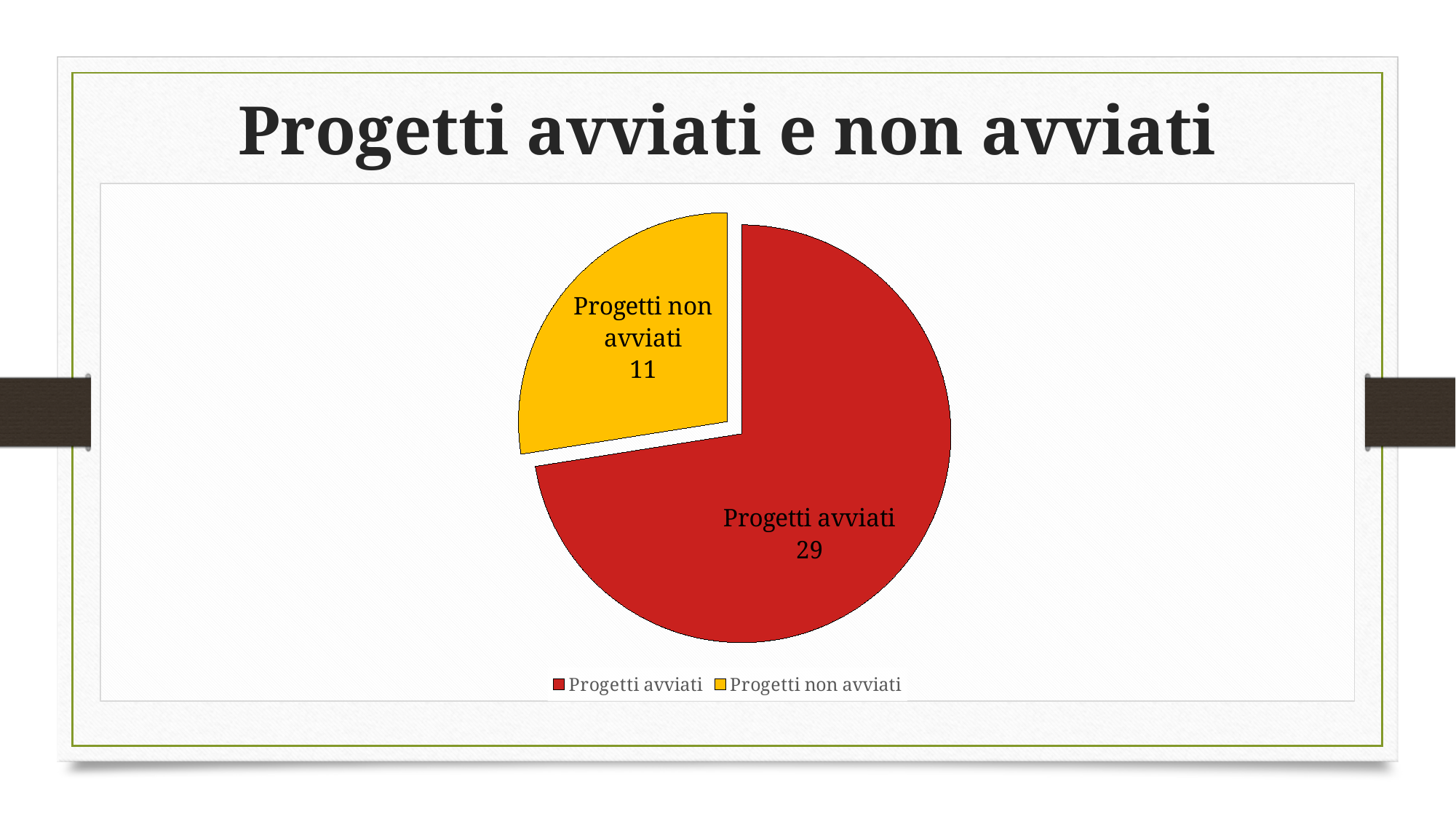
Which category has the smallest slice? Progetti non avviati Which category has the largest slice? Progetti avviati How many entries does the legend list? 2 What is the total of all slices in the pie chart? 40 What is the value for Progetti non avviati? 11 What colour is the Progetti non avviati slice? Yellow What type of chart is shown on the slide? Pie chart What is the difference between Progetti avviati and Progetti non avviati? 18 What share of the pie does Progetti avviati represent? 72.5% How many slices does the pie chart have? 2 What is the value for Progetti avviati? 29 Which is larger, Progetti avviati or Progetti non avviati? Progetti avviati